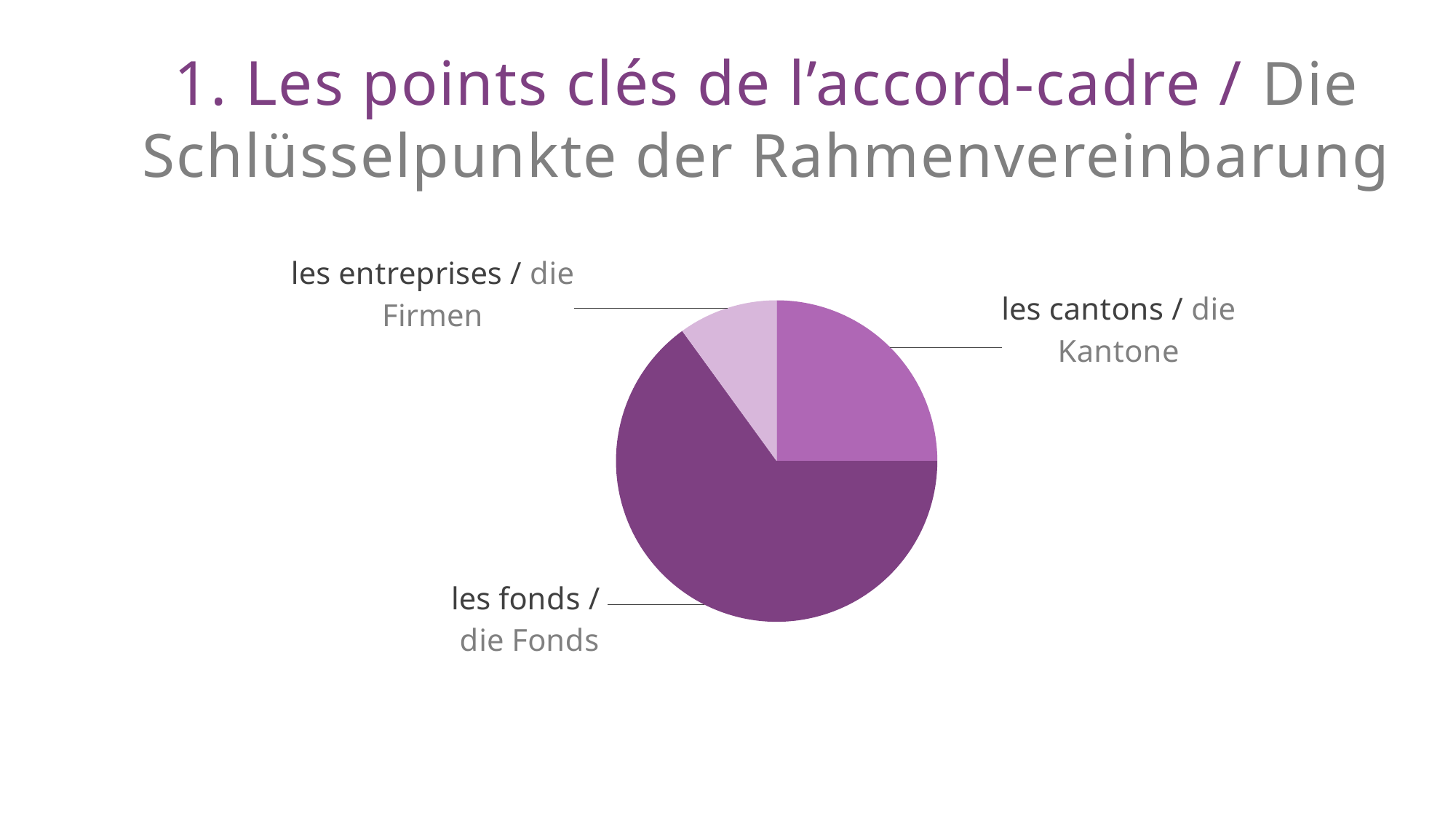
What kind of chart is shown on the slide? pie chart Which slice is larger: les fonds / die Fonds or les cantons / die Kantone? les fonds / die Fonds Does the slice for les fonds / die Fonds take up more or less than half of the pie? more Which category has the largest slice of the pie chart? les fonds / die Fonds What is the title of the slide containing the pie chart? 1. Les points clés de l'accord-cadre / Die Schlüsselpunkte der Rahmenvereinbarung Which category is shown in the lightest shade of purple in the pie chart? les entreprises / die Firmen Which category has the smallest slice of the pie chart? les entreprises / die Firmen Which slice is larger: les cantons / die Kantone or les entreprises / die Firmen? les cantons / die Kantone How many slices does the pie chart have? 3